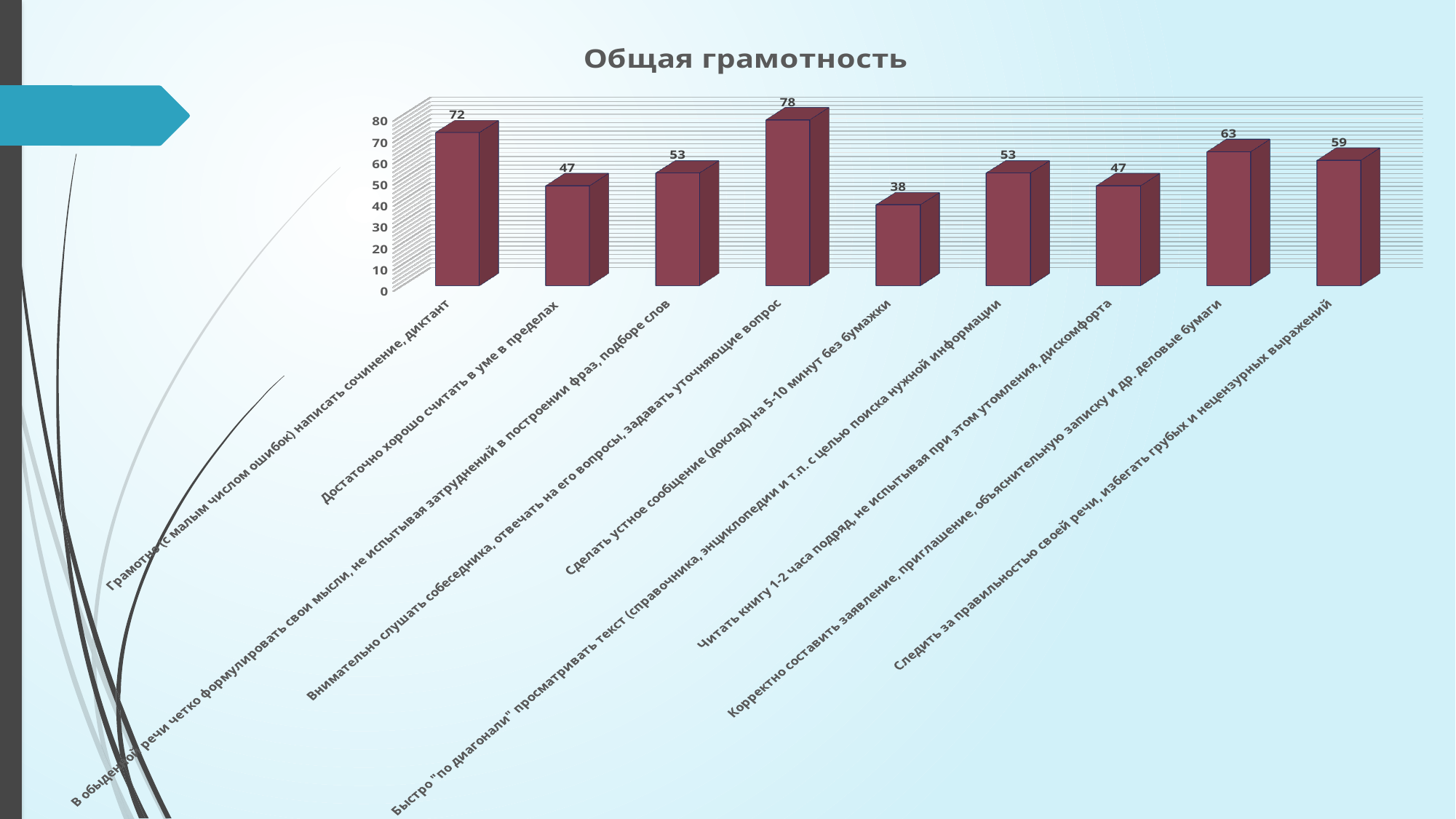
Which is larger: the value for "Достаточно хорошо считать в уме в пределах" or the value for "Корректно составить заявление, приглашение, объяснительную записку и др. деловые бумаги"? Корректно составить заявление, приглашение, объяснительную записку и др. деловые бумаги What type of chart is shown on the slide? bar chart Which category has the highest value? Внимательно слушать собеседника, отвечать на его вопросы, задавать уточняющие вопрос Which category has the lowest value? Сделать устное сообщение (доклад) на 5-10 минут без бумажки What is the value for "Сделать устное сообщение (доклад) на 5-10 минут без бумажки"? 38 What is the difference between the highest value (78) and the lowest value (38)? 40 What is the value for "Следить за правильностью своей речи, избегать грубых и нецензурных выражений"? 59 What is the value for "Корректно составить заявление, приглашение, объяснительную записку и др. деловые бумаги"? 63 What is the title of the chart? Общая грамотность How many bars (categories) does the chart show? 9 What is the value for "Грамотно (с малым числом ошибок) написать сочинение, диктант"? 72 Is the value for "Читать книгу 1-2 часа подряд, не испытывая при этом утомления, дискомфорта" greater or less than 50? less